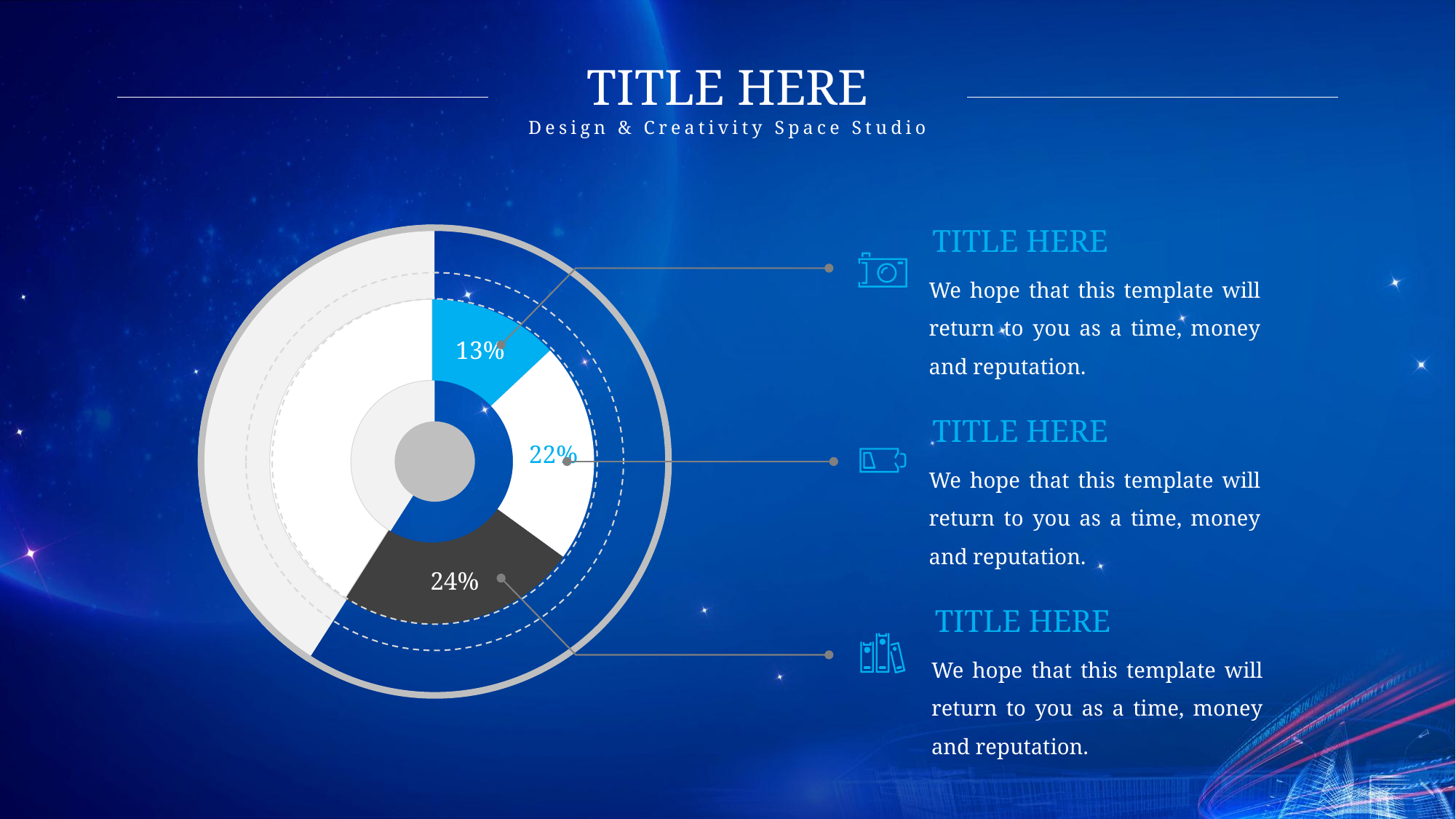
What percentage is shown on the dark gray slice of the pie chart? 24% Which is larger, the slice labeled 22% or the slice labeled 13%? 22% Among the slices with printed percentage labels, which value is the largest? 24% How many slices of the pie chart have a percentage label printed on them? 3 What kind of chart is shown on the slide? doughnut chart What percentage label is printed in blue text next to the white slice on the right side of the pie chart? 22% What is the combined total of the three labeled slices (13%, 22% and 24%)? 59% What is the main title at the top of the slide? TITLE HERE What percentage is shown on the light blue slice of the pie chart? 13% Among the slices with printed percentage labels, which value is the smallest? 13% What subtitle appears below the main title of the slide? Design & Creativity Space Studio What is the difference between the 24% slice and the 13% slice? 11%